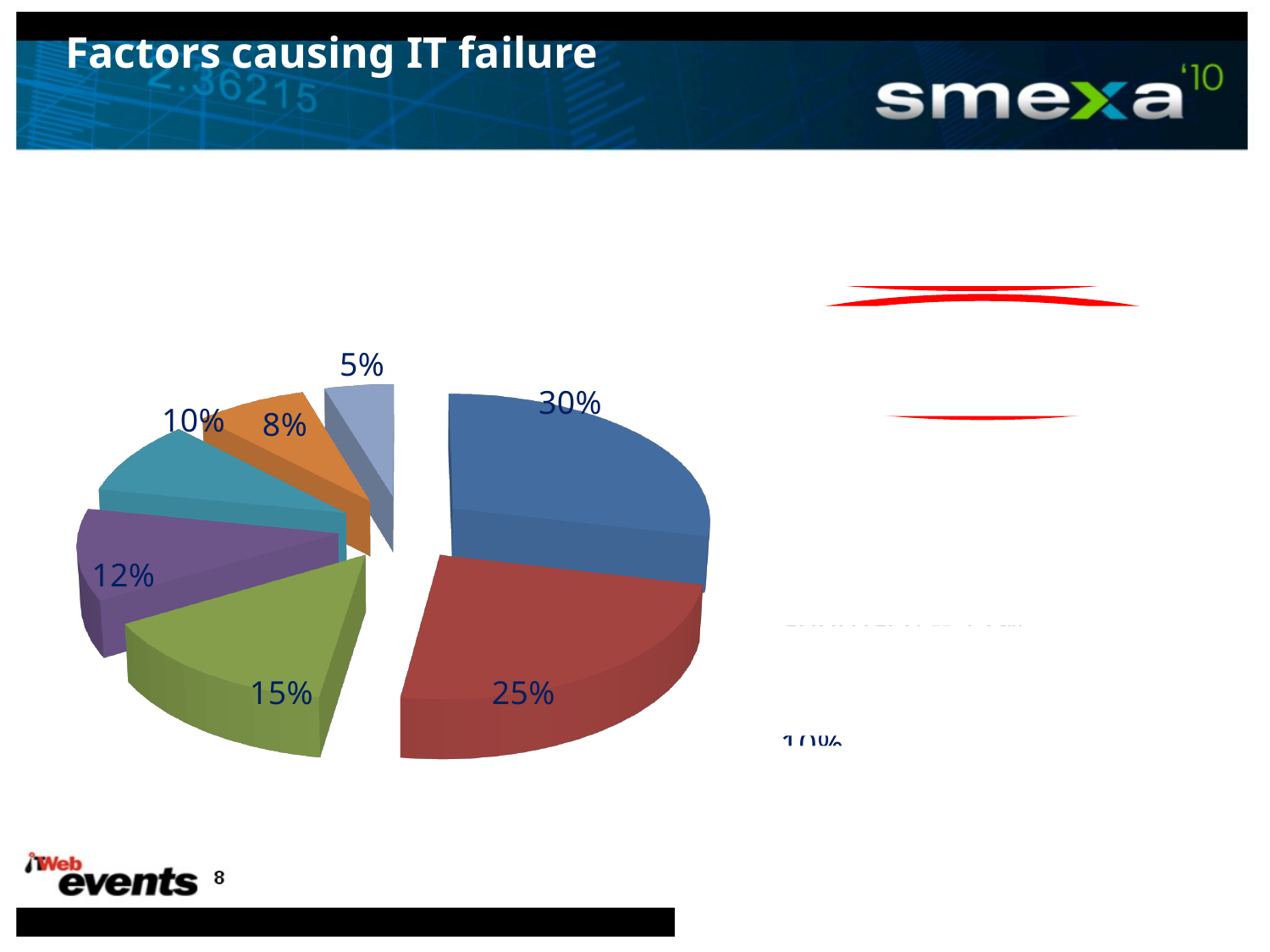
What percentage is shown on the dark blue slice of the pie chart? 30% What is the value of the smallest slice in the pie chart? 5% How many slices does the pie chart have? 7 What is the value of the largest slice in the pie chart? 30% What kind of chart is shown on the slide? pie chart What percentage is shown on the red slice of the pie chart? 25% Which slice is larger, the red slice or the green slice? the red slice What percentage is shown on the orange slice of the pie chart? 8% What is the difference in percentage points between the dark blue slice and the red slice? 5 What percentage is shown on the purple slice of the pie chart? 12% What percentage is shown on the green slice of the pie chart? 15% What is the title shown at the top of the slide above the pie chart? Factors causing IT failure